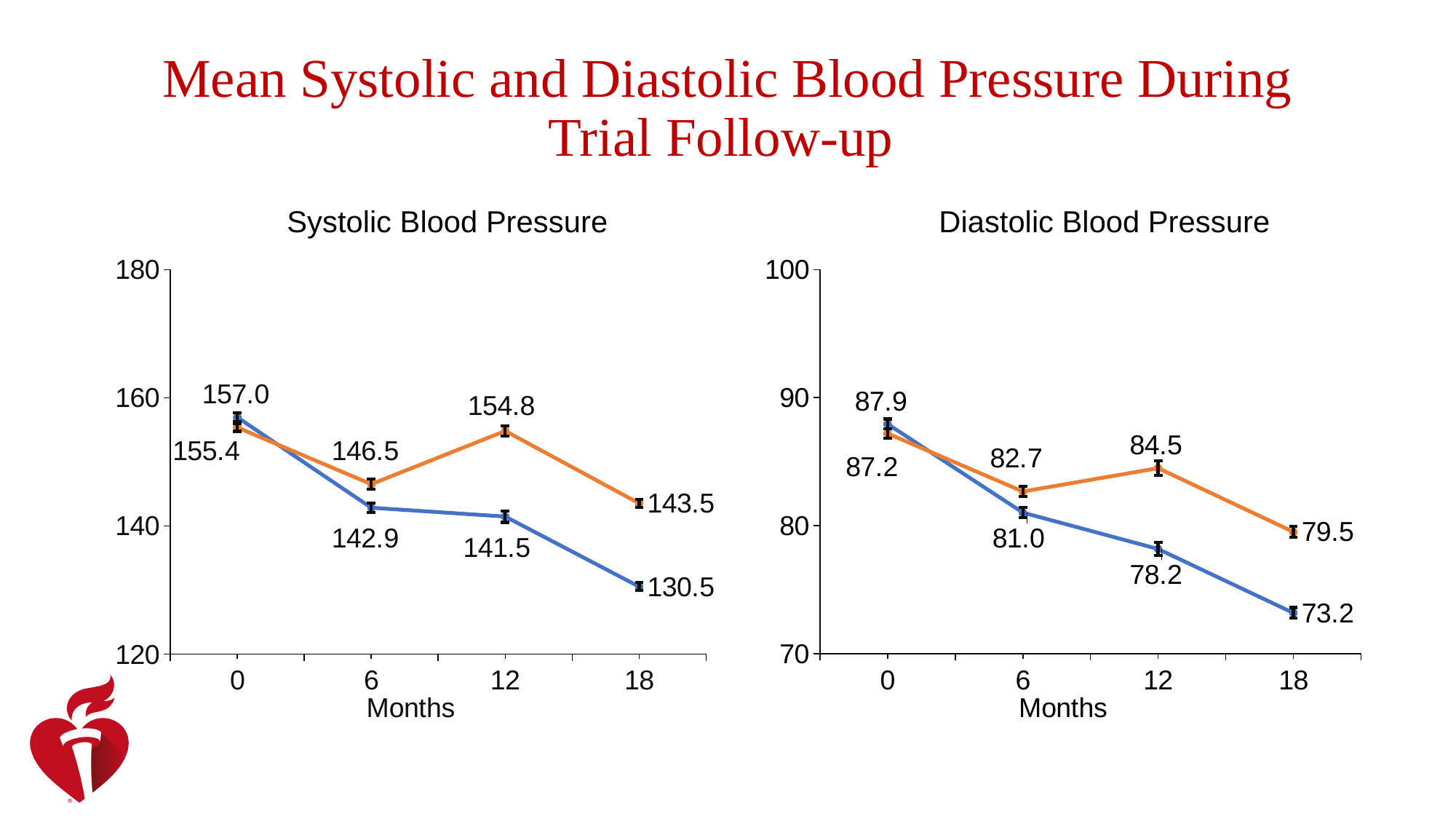
In the Systolic Blood Pressure chart, what is the value of the orange line at 12 months? 154.8 In the Diastolic Blood Pressure chart, what is the value of the blue line at 12 months? 78.2 In the Diastolic Blood Pressure chart, does the blue line rise or fall from 0 to 18 months? fall In the Systolic Blood Pressure chart, which line has the higher value at 6 months, blue or orange? orange In the Systolic Blood Pressure chart, what is the value of the blue line at 18 months? 130.5 In the Diastolic Blood Pressure chart, at which month does the blue line reach its lowest value? 18 How many time points are plotted on the x axis of the Diastolic Blood Pressure chart? 4 In the Diastolic Blood Pressure chart, what is the difference between the blue line's value at 0 months and at 18 months? 14.7 What type of chart is the Systolic Blood Pressure chart? line chart In the Systolic Blood Pressure chart, what is the difference between the orange and blue lines at 18 months? 13.0 In the Diastolic Blood Pressure chart, what is the value of the orange line at 6 months? 82.7 In the Systolic Blood Pressure chart, at which month does the orange line reach its highest value? 0